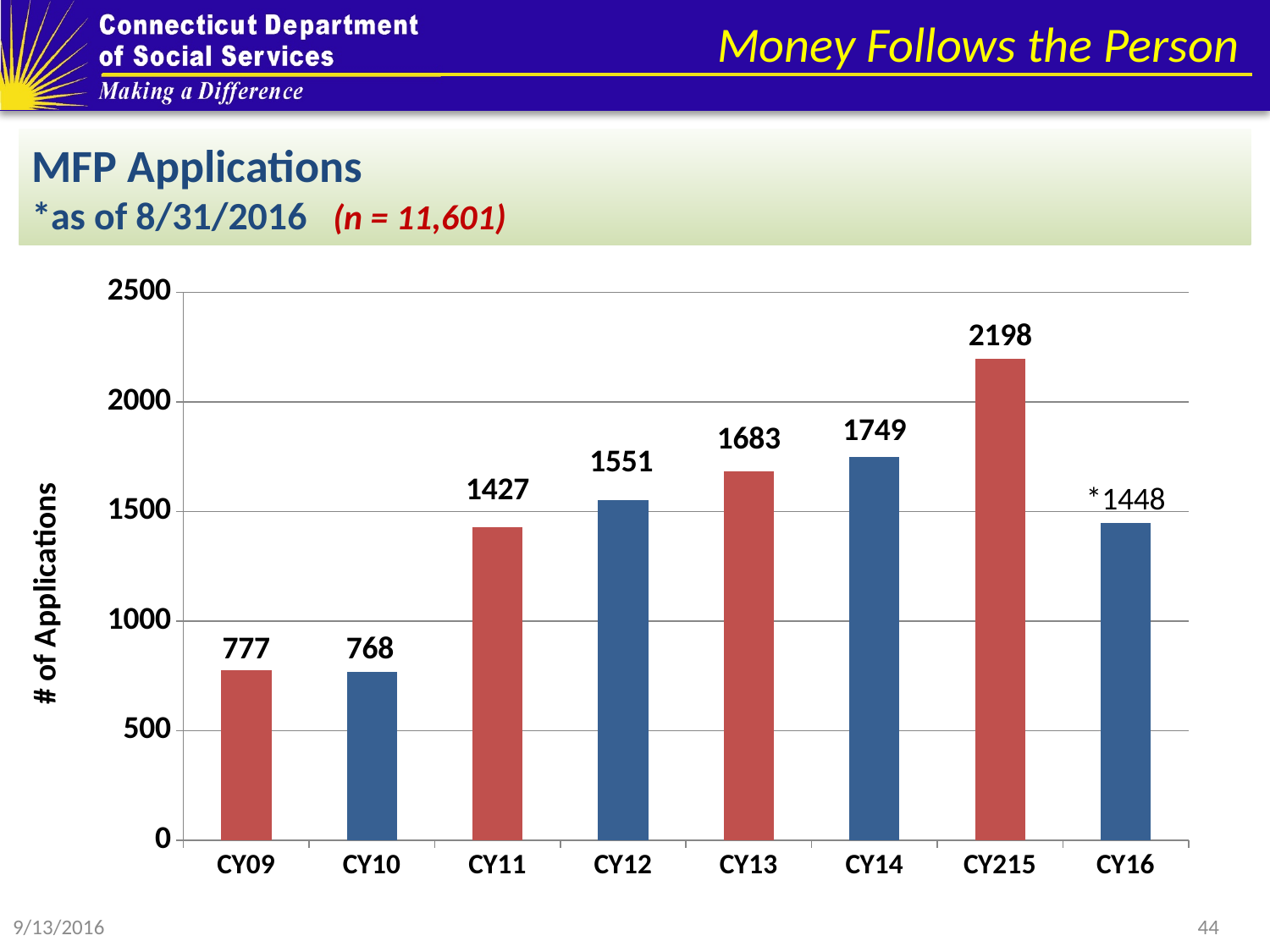
Which has more applications, CY11 or CY12? CY12 What is the number of applications for CY09? 777 Is the value for CY13 greater or less than 1500? greater What is the number of applications for CY12? 1551 How many categories are shown on the x axis? 8 What is the number of applications for CY16? 1448 What is the difference in applications between CY215 and CY16? 750 What is the label of the y axis? # of Applications Which category has the highest number of applications? CY215 Which category has the lowest number of applications? CY10 What kind of chart is shown on the slide? bar chart What is the difference in applications between CY14 and CY13? 66